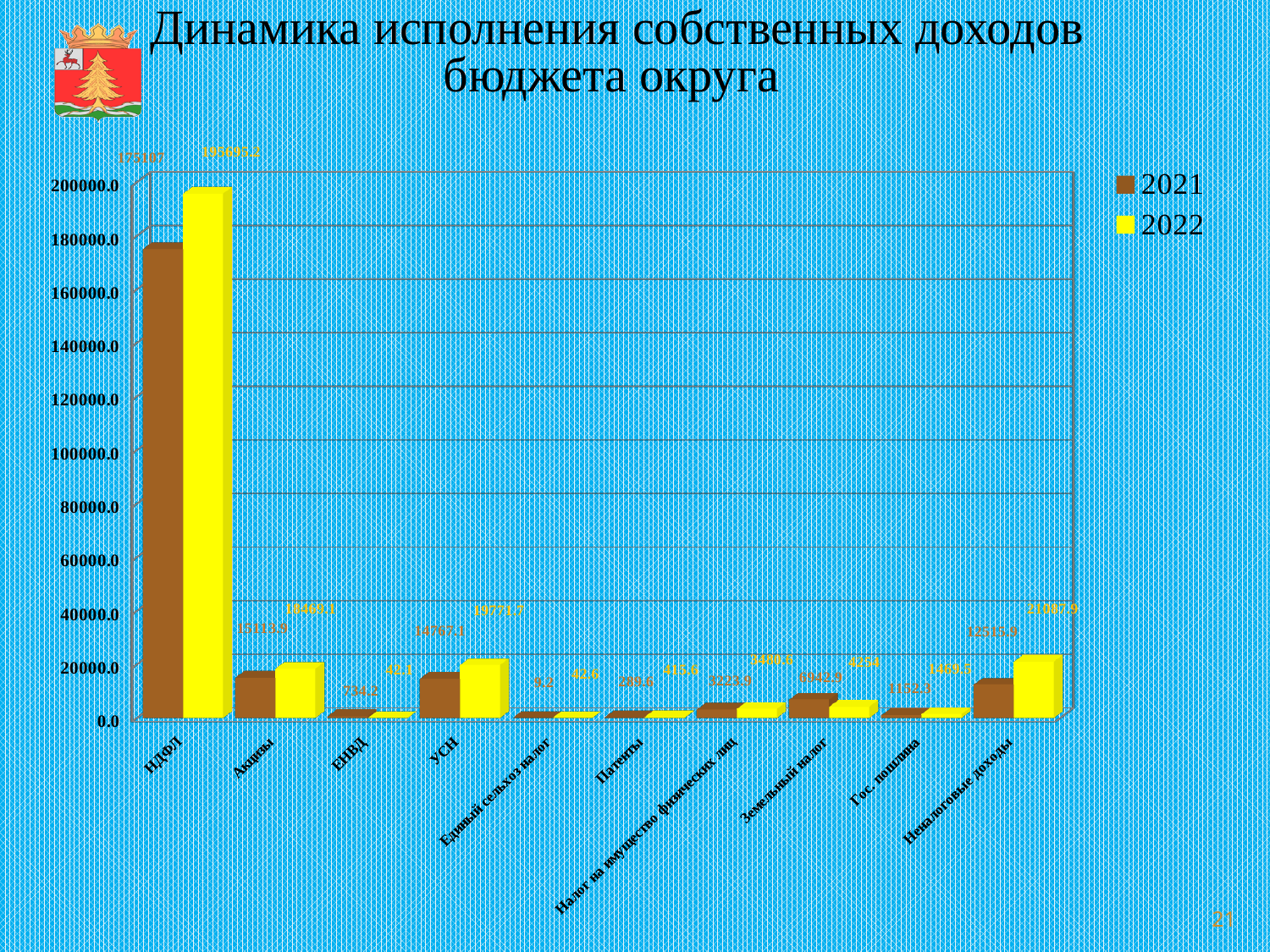
How many series does the legend list? 2 Which category has the highest value for 2022? НДФЛ What kind of chart is shown on the slide? bar chart For Неналоговые доходы, which series has the larger value, 2021 or 2022? 2022 Is the 2022 value for Акцизы greater or less than 40000.0? less For Земельный налог, which series has the larger value, 2021 or 2022? 2021 Is the 2022 value for НДФЛ greater or less than 180000.0? greater Which years are listed in the legend? 2021 and 2022 What colour are the bars for the 2022 series? yellow Which category has the highest value for 2021? НДФЛ Is the 2021 value for НДФЛ greater or less than 160000.0? greater How many categories are shown on the x axis? 10